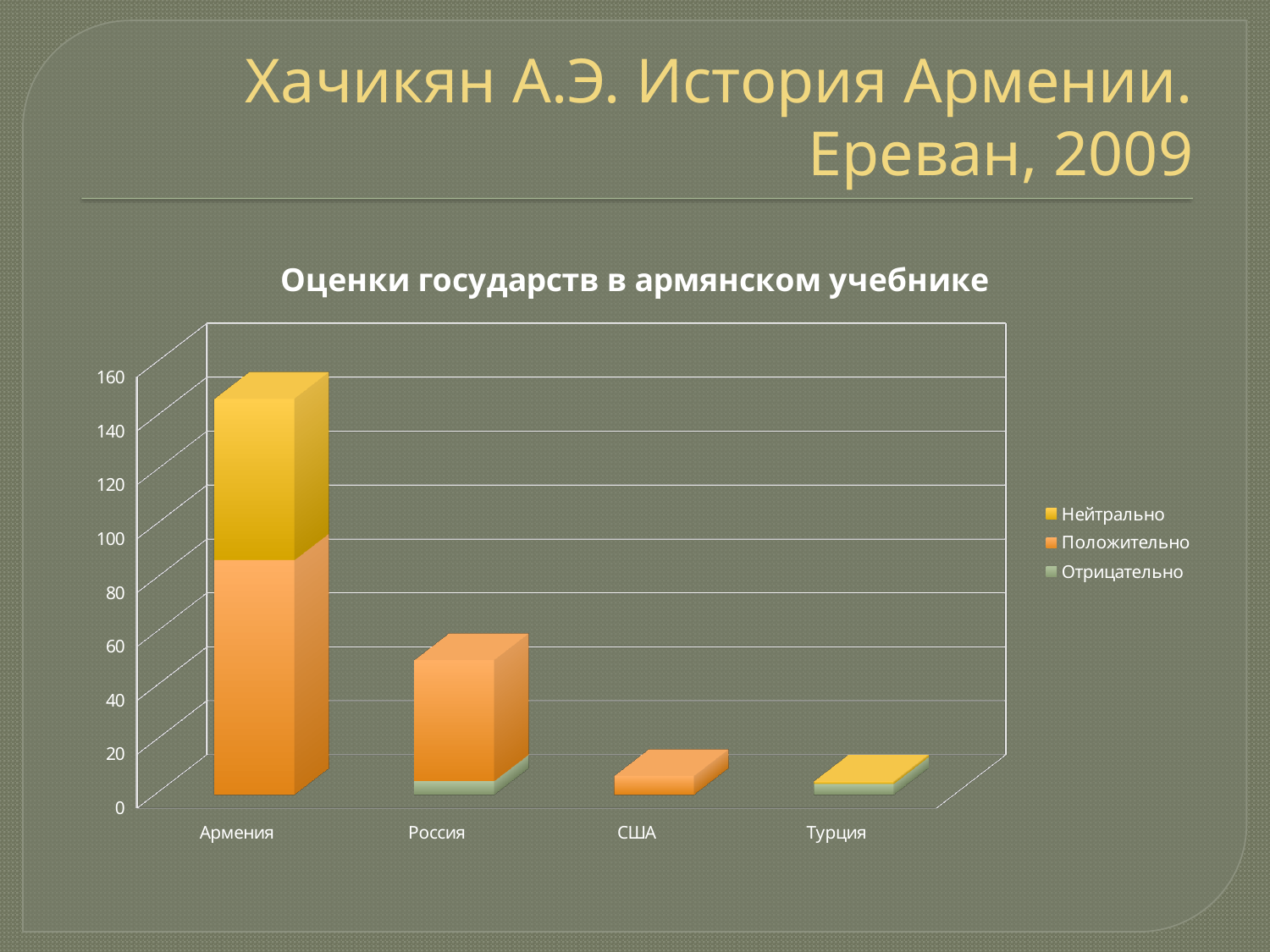
What is the title of the chart? Оценки государств в армянском учебнике Is the total stacked value for США greater or less than 20? less How many series does the chart legend list? 3 How many countries (categories) are shown on the x axis of the chart? 4 Is the total stacked value for Армения greater or less than 100? greater Which stacked bar is taller, Армения or Россия? Армения Which country is the only one whose bar contains a Нейтрально segment besides Армения? Турция Is the total stacked value for Россия greater or less than 80? less Which country has the tallest stacked bar in the chart? Армения What kind of chart is shown on the slide? stacked bar chart Which series are listed in the chart legend? Нейтрально, Положительно, Отрицательно